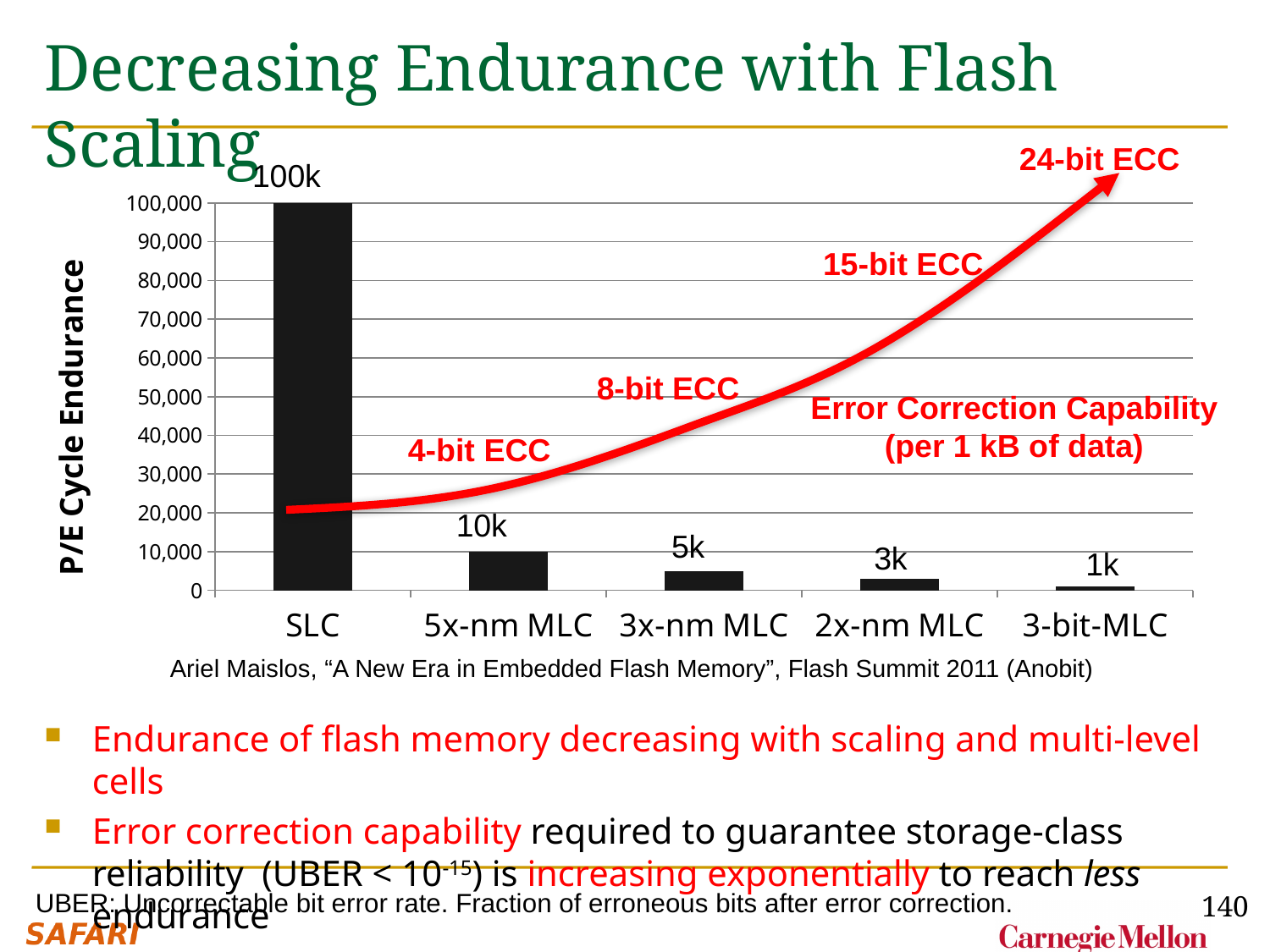
Do the P/E cycle endurance values rise or fall from left to right along the x axis? fall What kind of chart is used to show P/E cycle endurance? bar chart What is the label of the y axis of the chart? P/E Cycle Endurance What is the P/E cycle endurance shown for 3-bit-MLC? 1k What is the P/E cycle endurance shown for SLC? 100k What is the difference in P/E cycle endurance between 5x-nm MLC and 2x-nm MLC? 7k Is the P/E cycle endurance for 5x-nm MLC greater or less than 20,000? less Which category has the lowest P/E cycle endurance? 3-bit-MLC How many categories are shown on the x axis of the chart? 5 Which category has the highest P/E cycle endurance? SLC Which has a higher P/E cycle endurance, 3x-nm MLC or 2x-nm MLC? 3x-nm MLC What is the P/E cycle endurance shown for 3x-nm MLC? 5k